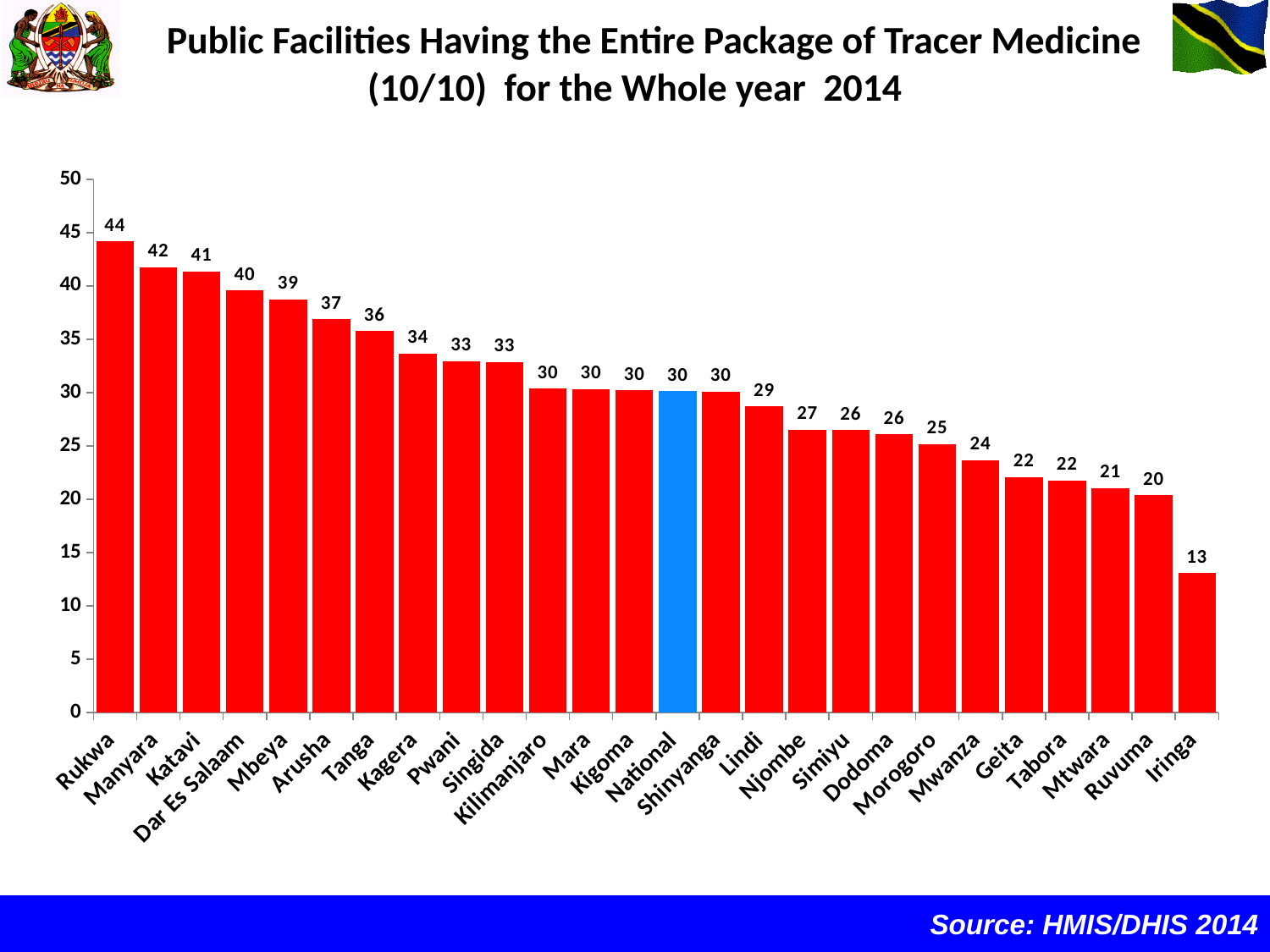
Which bar is coloured blue instead of red? National What is the value for Dodoma? 26 Which region has the lowest value? Iringa Which has a larger value, Mbeya or Lindi? Mbeya What kind of chart is shown on the slide? Bar chart What is the value for Rukwa? 44 What is the value for National? 30 What is the difference between the values for Rukwa and Iringa? 31 How many bars are shown in the chart? 26 Which region has the highest value? Rukwa What is the difference between the values for Dar Es Salaam and Mwanza? 16 Is the value for Tanga greater or less than 30? greater